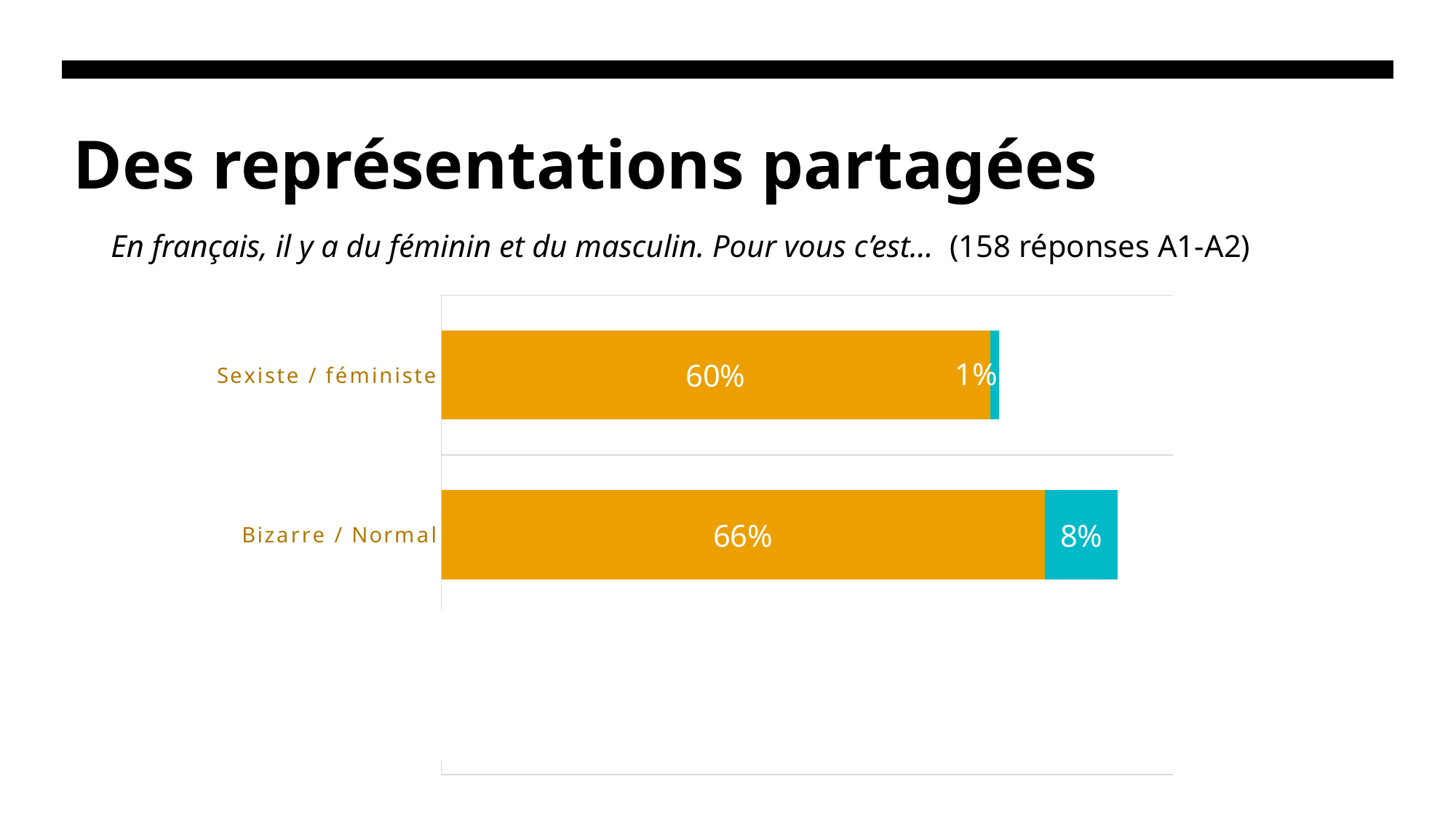
How many categories are plotted in the chart? 2 What is the value of the orange segment for Sexiste / féministe? 60% Which category has the smaller teal segment? Sexiste / féministe Is the teal segment larger for Bizarre / Normal or for Sexiste / féministe? Bizarre / Normal What is the value of the teal segment for Sexiste / féministe? 1% What is the value of the orange segment for Bizarre / Normal? 66% Which category has the larger orange segment? Bizarre / Normal What kind of chart is shown on the slide? bar chart What is the difference between the orange values for Bizarre / Normal and Sexiste / féministe? 6% What is the value of the teal segment for Bizarre / Normal? 8% What is the total of the stacked bar for Bizarre / Normal? 74% What is the total of the stacked bar for Sexiste / féministe? 61%